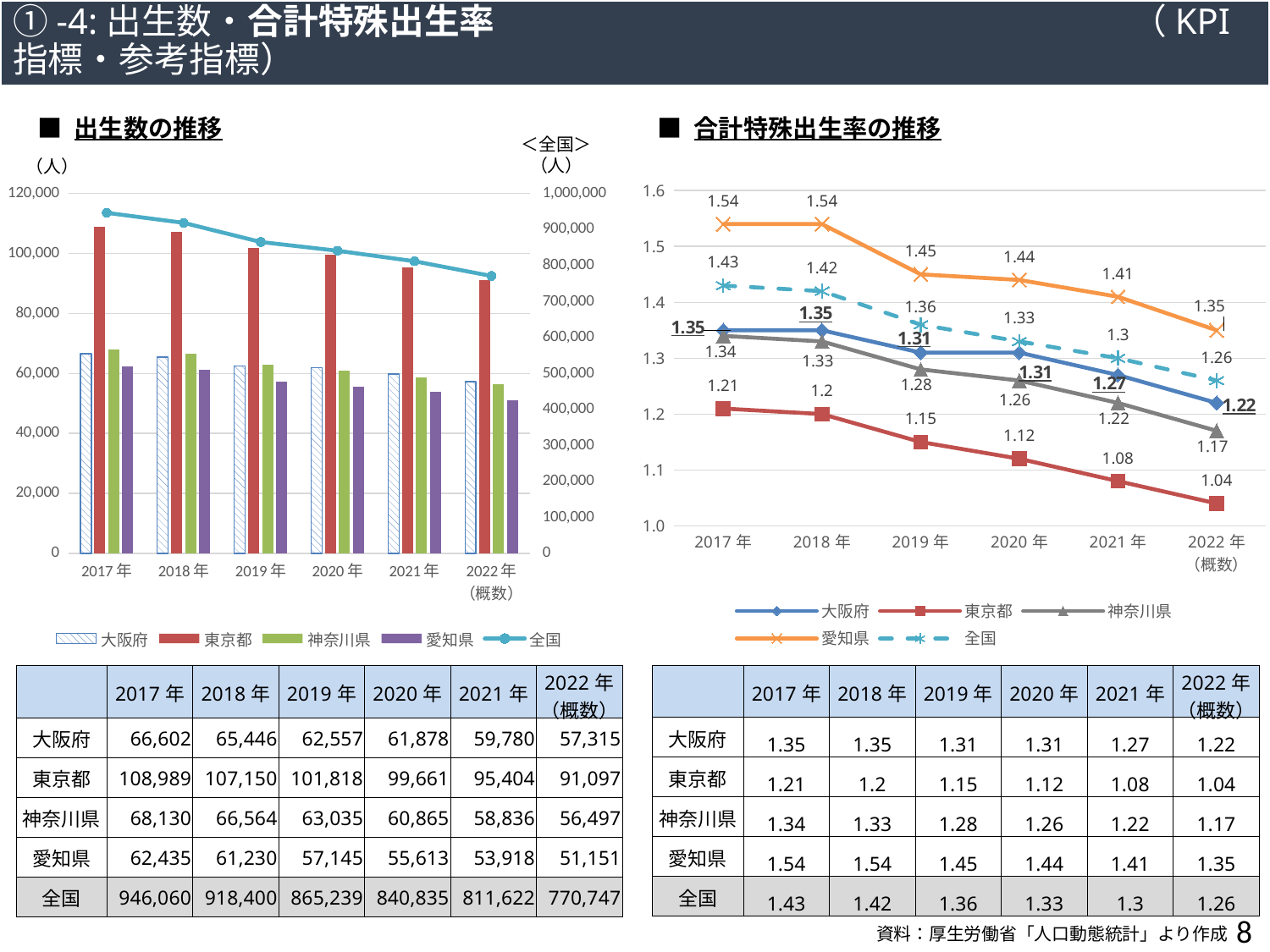
What kind of chart is the 合計特殊出生率の推移 chart on the right? line chart In the 出生数の推移 chart on the left, is the bar for 東京都 in 2017年 greater or less than 100,000? greater In the 合計特殊出生率の推移 chart on the right, what is the value for 愛知県 in 2019年? 1.45 How many series does the legend of the 合計特殊出生率の推移 chart on the right list? 5 In the 合計特殊出生率の推移 chart on the right, which is larger in 2019年: 神奈川県 or 全国? 全国 In the 合計特殊出生率の推移 chart on the right, which series has the highest value in 2017年? 愛知県 In the 合計特殊出生率の推移 chart on the right, what is the value for 大阪府 in 2022年(概数)? 1.22 In the 合計特殊出生率の推移 chart on the right, does the value for 東京都 rise or fall from 2017年 to 2022年(概数)? fall How many years are shown on the x axis of the 出生数の推移 chart on the left? 6 In the 合計特殊出生率の推移 chart on the right, which series has the lowest value in 2022年(概数)? 東京都 In the 出生数の推移 chart on the left, which prefecture has the tallest bar in 2022年(概数)? 東京都 In the 合計特殊出生率の推移 chart on the right, by how much did the value for 愛知県 fall from 2017年 to 2022年(概数)? 0.19